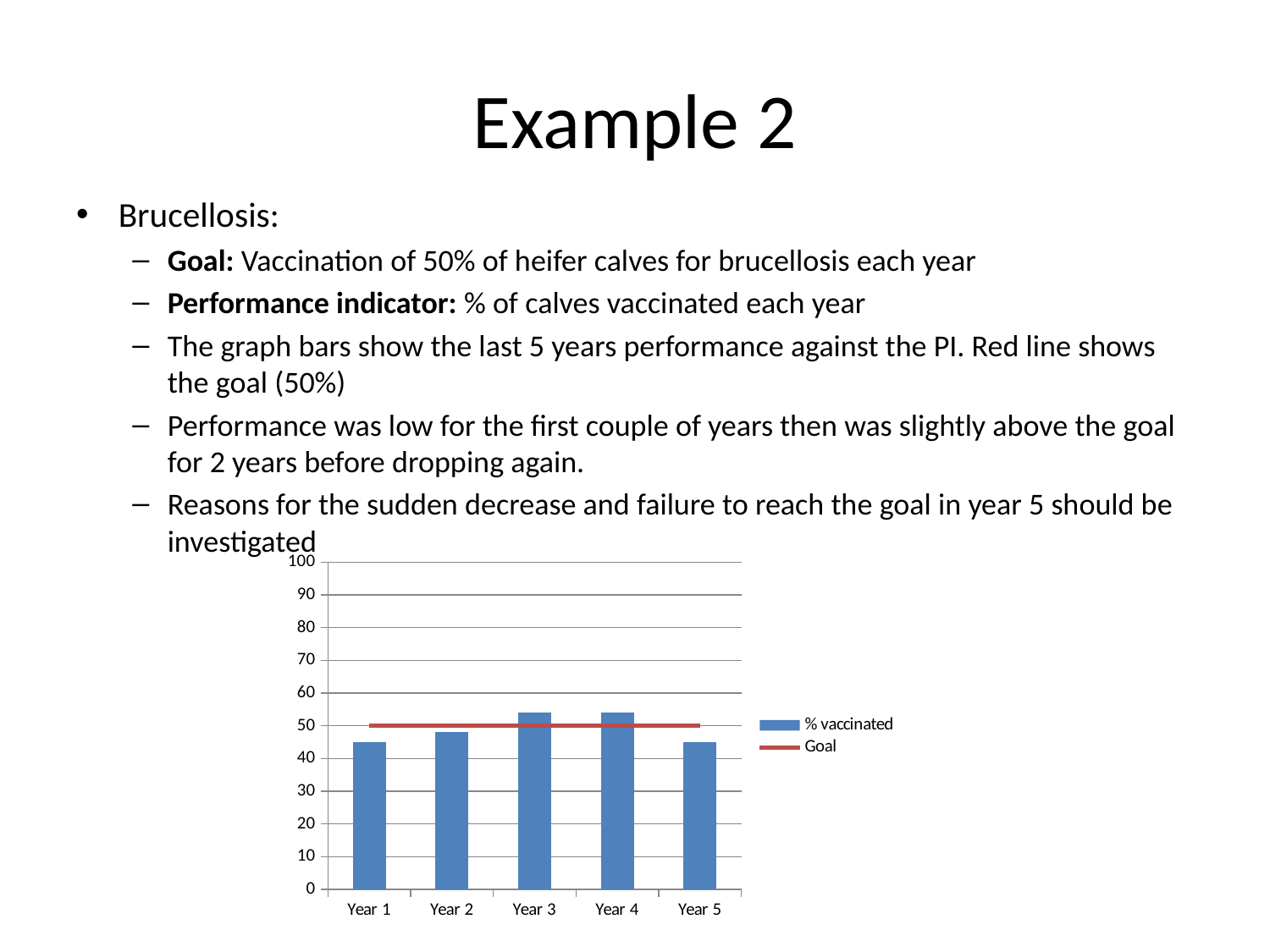
How many series does the chart legend list? 2 Is the % vaccinated value for Year 1 greater or less than 40? greater What kind of chart is shown on the slide? combination bar and line chart How many years are shown on the x axis of the chart? 5 What are the two entries listed in the chart legend? % vaccinated and Goal Is the % vaccinated value for Year 1 greater or less than 50? less Is the % vaccinated value for Year 3 greater or less than 50? greater Which has a higher % vaccinated value, Year 4 or Year 5? Year 4 What value does the Goal line sit at on the chart? 50 Which has a higher % vaccinated value, Year 3 or Year 1? Year 3